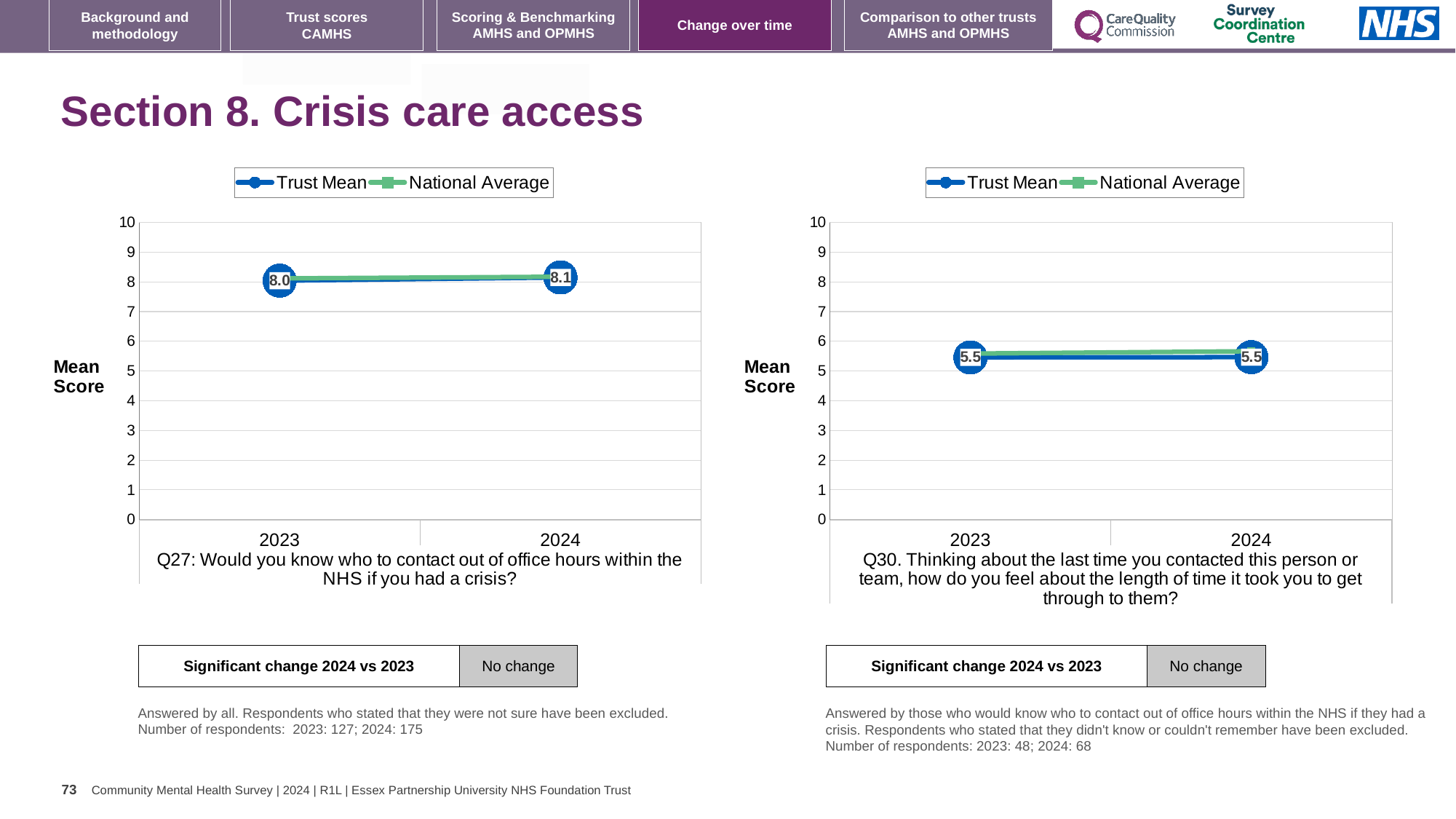
On the left chart (Q27), what is the difference between the Trust Mean scores for 2024 and 2023? 0.1 On the right chart (Q30), what is the Trust Mean score for 2024? 5.5 What are the two series named in the legend of the right chart (Q30)? Trust Mean and National Average On the left chart (Q27), what is the Trust Mean score for 2023? 8.0 What kind of chart is the right chart (Q30)? line chart On the left chart (Q27), does the Trust Mean rise or fall from 2023 to 2024? rise How many series does the legend of the left chart (Q27) list? 2 On the left chart (Q27), is the Trust Mean for 2023 greater or less than 7? greater On the right chart (Q30), what is the Trust Mean score for 2023? 5.5 On the left chart (Q27), what is the Trust Mean score for 2024? 8.1 How many years are plotted on the x axis of the right chart (Q30)? 2 On the right chart (Q30), is the Trust Mean for 2024 greater or less than 6? less